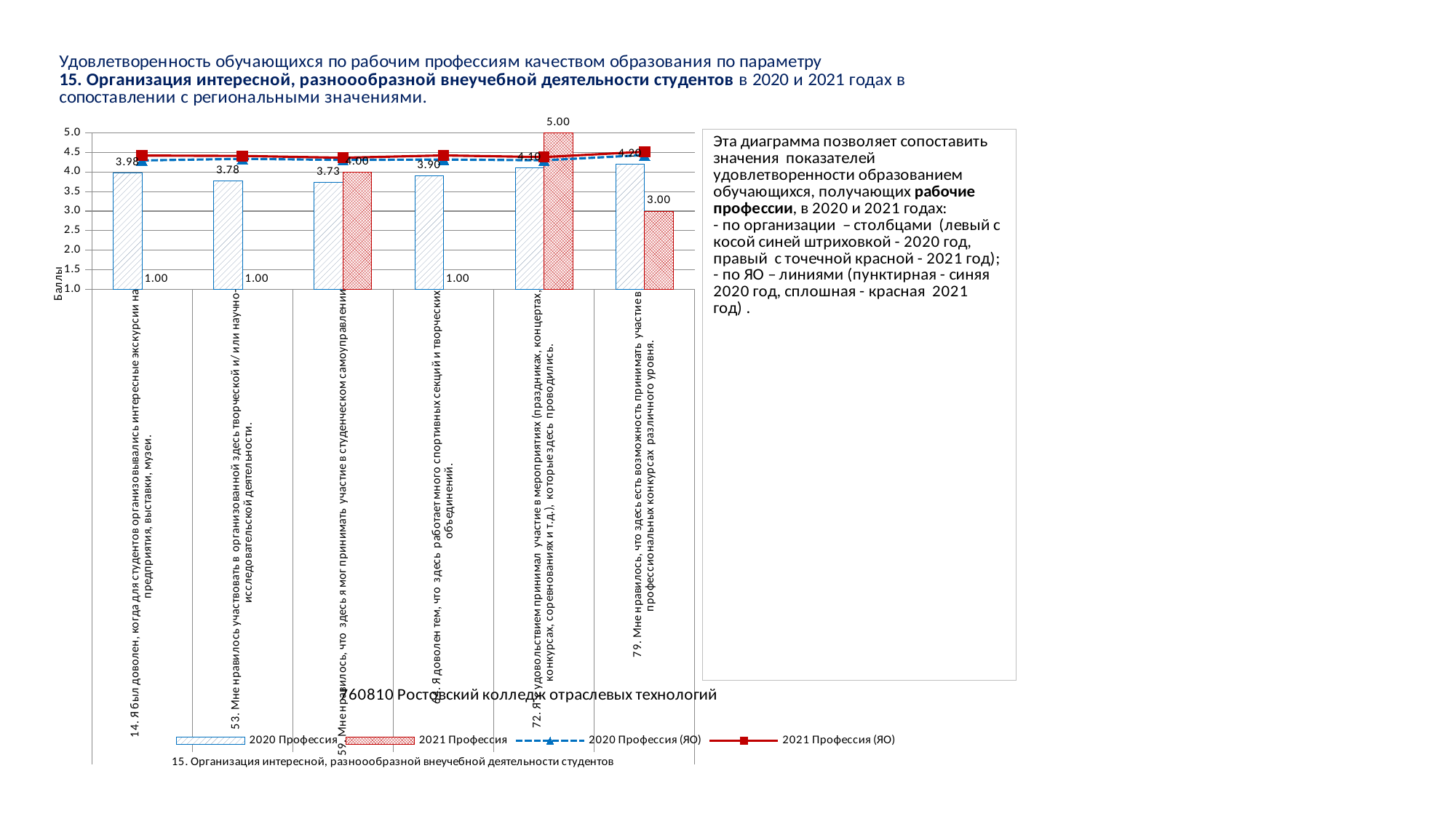
What kind of chart is shown on the slide? Combined bar and line chart What is the value of the 2021 Профессия bar for question 72 (участие в мероприятиях: праздниках, концертах, конкурсах, соревнованиях)? 5.00 Is the 2021 Профессия (ЯО) line value for question 14 greater or less than 4.0? greater For which question does the 2021 Профессия series reach its highest value? 72 (5.00) What is the value of the 2021 Профессия bar for question 79 (возможность принимать участие в профессиональных конкурсах)? 3.00 What is the value of the 2020 Профессия bar for question 53 (участвовать в творческой и/или научно-исследовательской деятельности)? 3.78 How many series does the chart legend list? 4 For which question is the 2020 Профессия bar the lowest? 59 (3.73) What is the value of the 2020 Профессия bar for question 14 (Я был доволен, когда для студентов организовывались интересные экскурсии...)? 3.98 For question 59 (участие в студенческом самоуправлении), which is larger: the 2020 Профессия bar or the 2021 Профессия bar? 2021 Профессия (4.00) What is the difference between the 2021 Профессия values for question 72 and question 79? 2.00 How many survey questions (categories) are shown on the x axis of the chart? 6